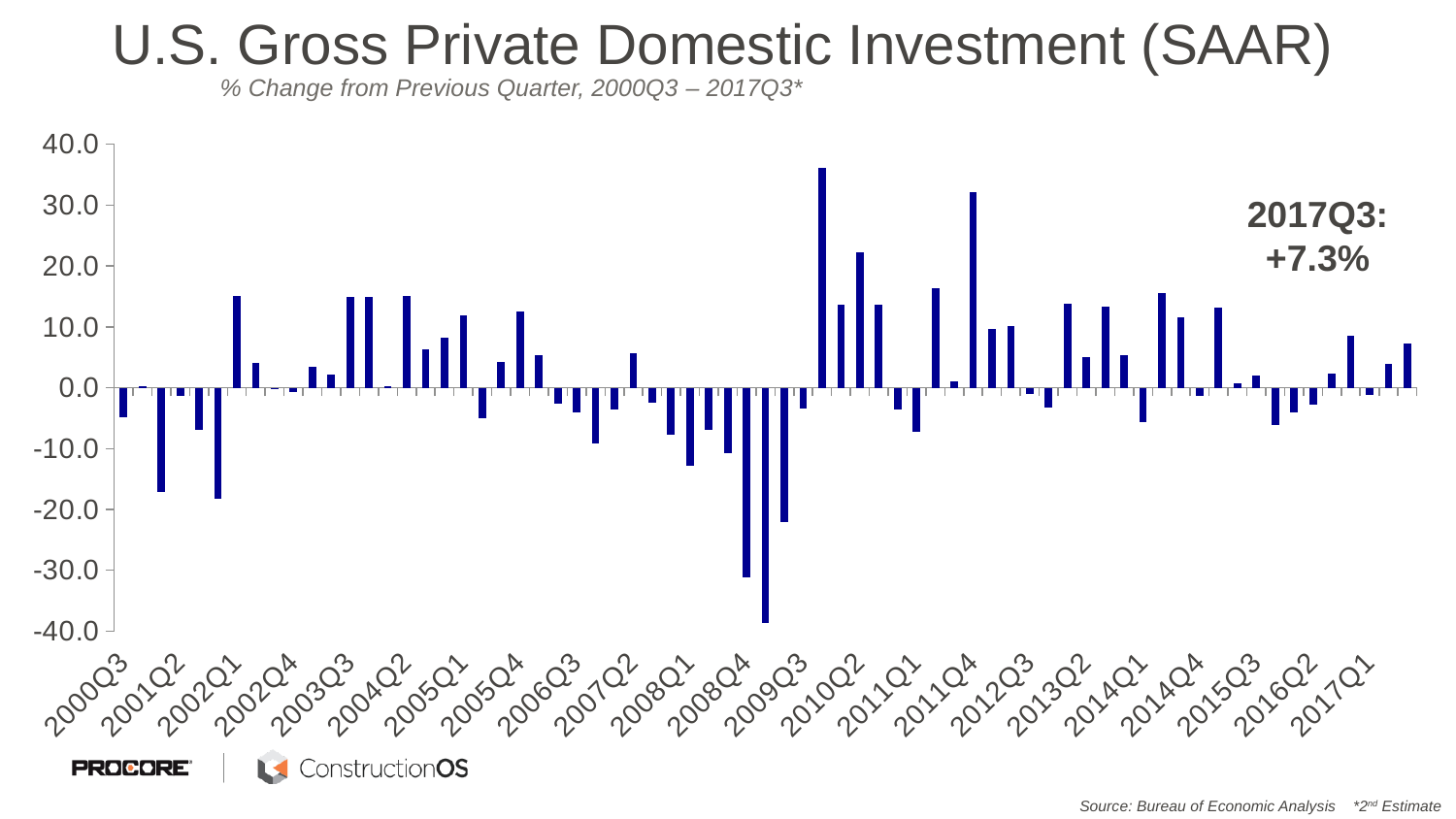
What is the title of the chart? U.S. Gross Private Domestic Investment (SAAR) Is the value for 2014Q1 greater or less than 0.0? less What source is cited for the chart data? Bureau of Economic Analysis Is the value for 2002Q1 greater or less than 10.0? greater Is the value for 2011Q4 greater or less than 20.0? greater What is the value shown for 2017Q3? +7.3% Which is larger, the value for 2011Q4 or the value for 2005Q1? 2011Q4 Which is larger, the value for 2002Q1 or the value for 2008Q1? 2002Q1 What kind of chart is shown on the slide? bar chart